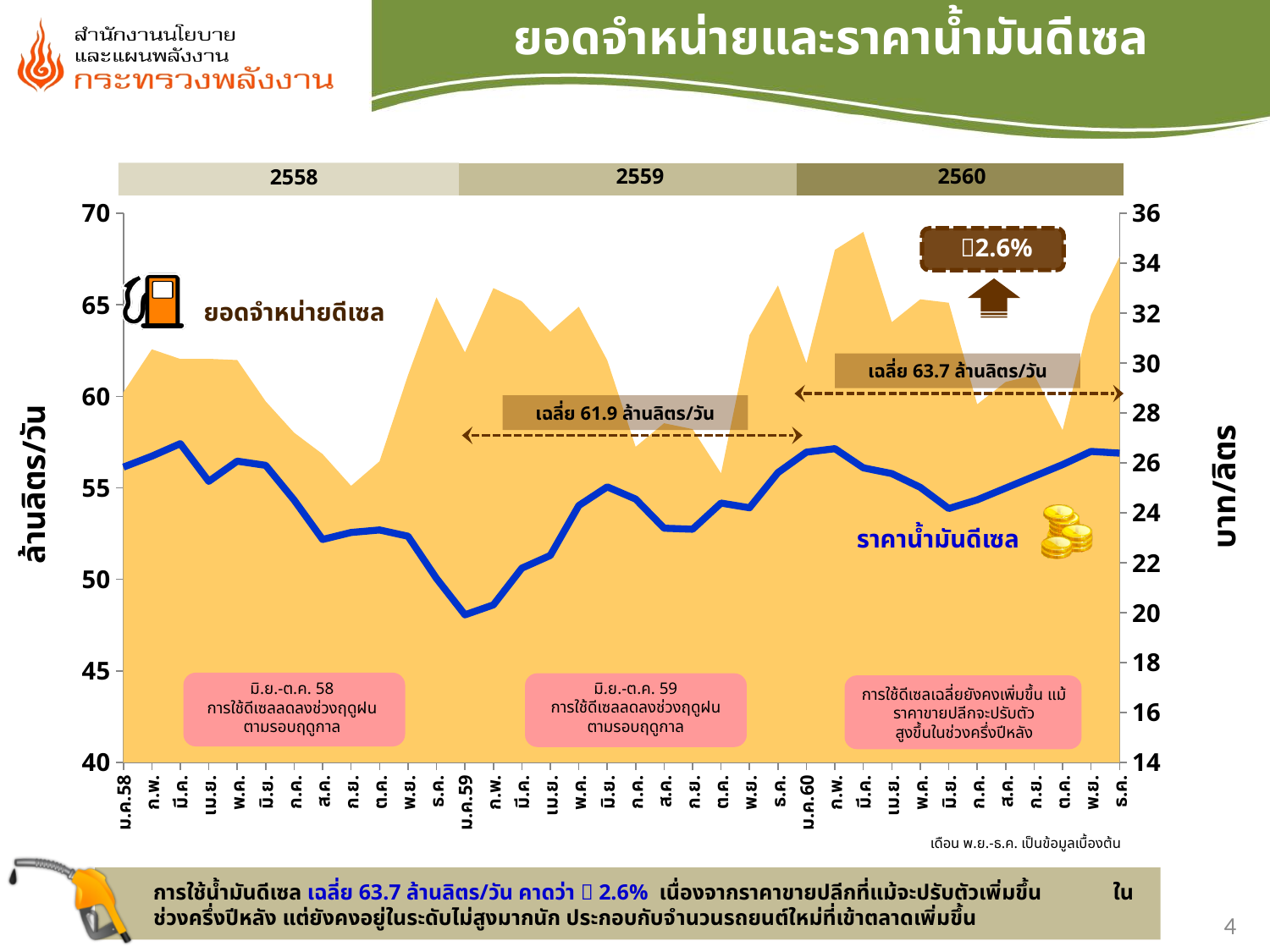
Does the diesel price line rise or fall from ม.ค.58 to ม.ค.59? fall Which year has the larger average diesel sales volume, 2559 or 2560? 2560 What kind of chart is shown on the slide? A combined area and line chart Is the diesel sales volume (ยอดจำหน่ายดีเซล) in ธ.ค. 2560 greater or less than 65 ล้านลิตร/วัน? greater What percentage change is shown in the callout box at the top right of the chart? 2.6% By how much does the 2560 average diesel sales volume exceed the 2559 average? 1.8 ล้านลิตร/วัน What is the average diesel sales volume shown for 2559? 61.9 ล้านลิตร/วัน How many years are shown along the top of the chart? 3 Is the diesel price (ราคาน้ำมันดีเซล) in ม.ค.59 greater or less than 22 บาท/ลิตร? less What is the unit label on the right-hand axis? บาท/ลิตร What is the title of the chart on the slide? ยอดจำหน่ายและราคาน้ำมันดีเซล What is the average diesel sales volume shown for 2560? 63.7 ล้านลิตร/วัน